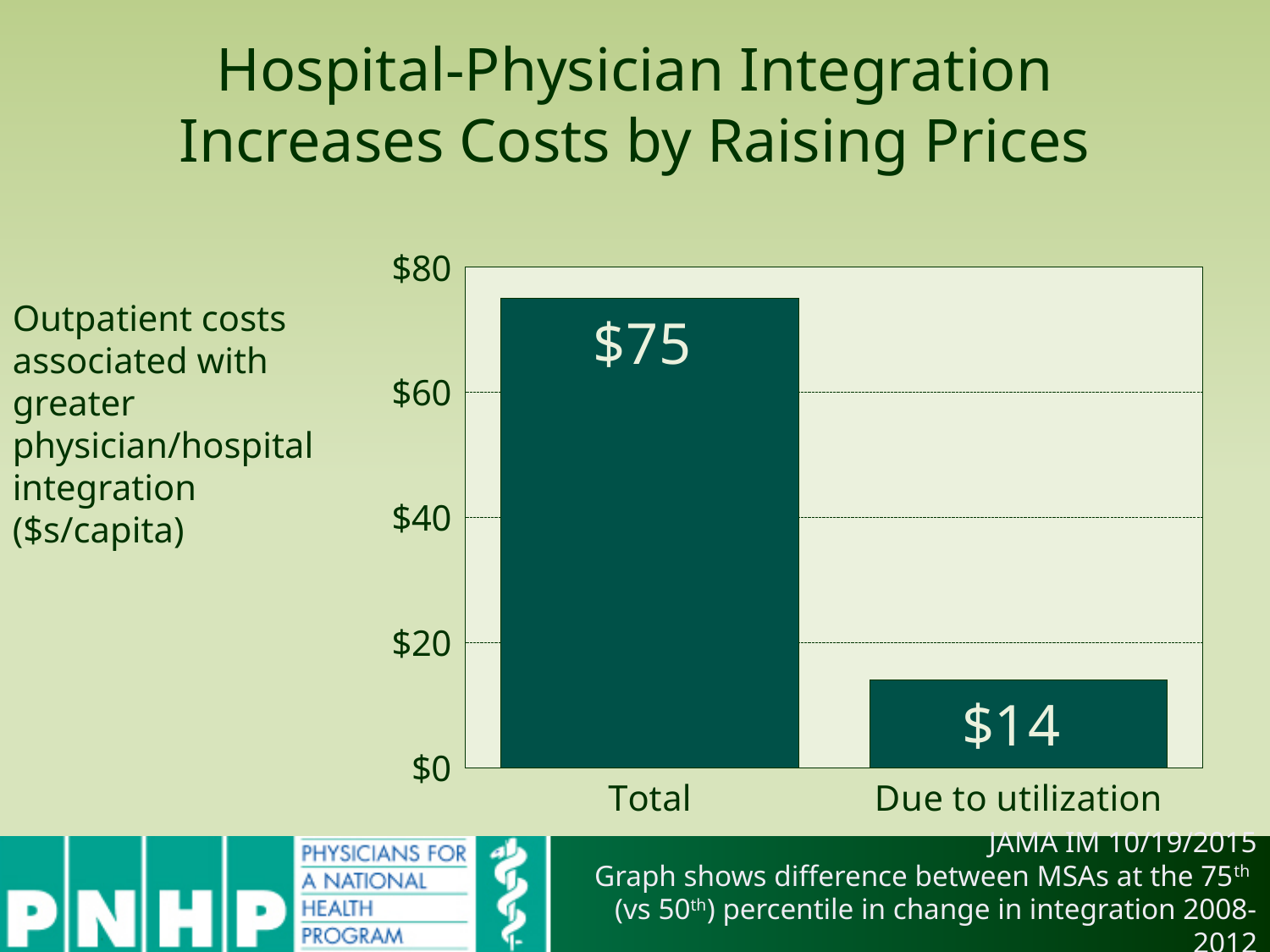
What kind of chart is shown on the slide? bar chart What is the value for Due to utilization? $14 Which is larger, the value for Total or the value for Due to utilization? Total What is the title of the slide containing the chart? Hospital-Physician Integration Increases Costs by Raising Prices What is the highest value labelled on the y axis? $80 What is the difference between the Total value and the Due to utilization value? $61 Is the value for Total greater or less than $60? greater Which category has the lowest value? Due to utilization How many categories are shown on the chart? 2 Which category has the highest value? Total Is the value for Due to utilization greater or less than $20? less What is the value for Total? $75